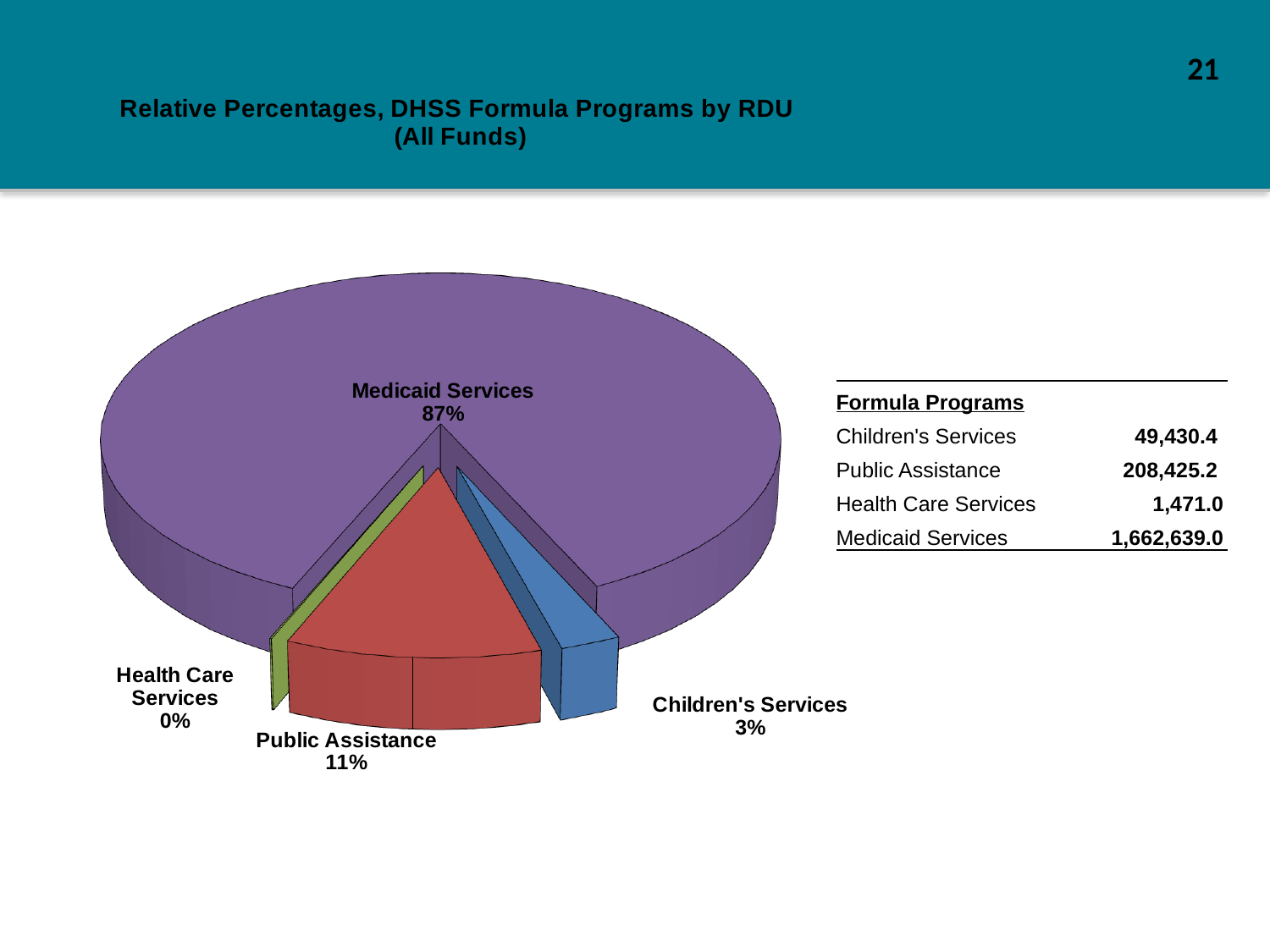
What percentage share does Health Care Services have in the pie chart? 0% Which is larger in the pie chart, Public Assistance or Children's Services? Public Assistance What percentage share does Medicaid Services have in the pie chart? 87% What type of chart is shown on the slide? Pie chart How many slices does the pie chart have? 4 What is the title of the chart on the slide? Relative Percentages, DHSS Formula Programs by RDU (All Funds) What percentage share does Public Assistance have in the pie chart? 11% What is the difference in percentage points between the Medicaid Services slice and the Public Assistance slice? 76 Which category has the smallest slice of the pie chart? Health Care Services Which category has the largest slice of the pie chart? Medicaid Services What colour is the Medicaid Services slice in the pie chart? Purple